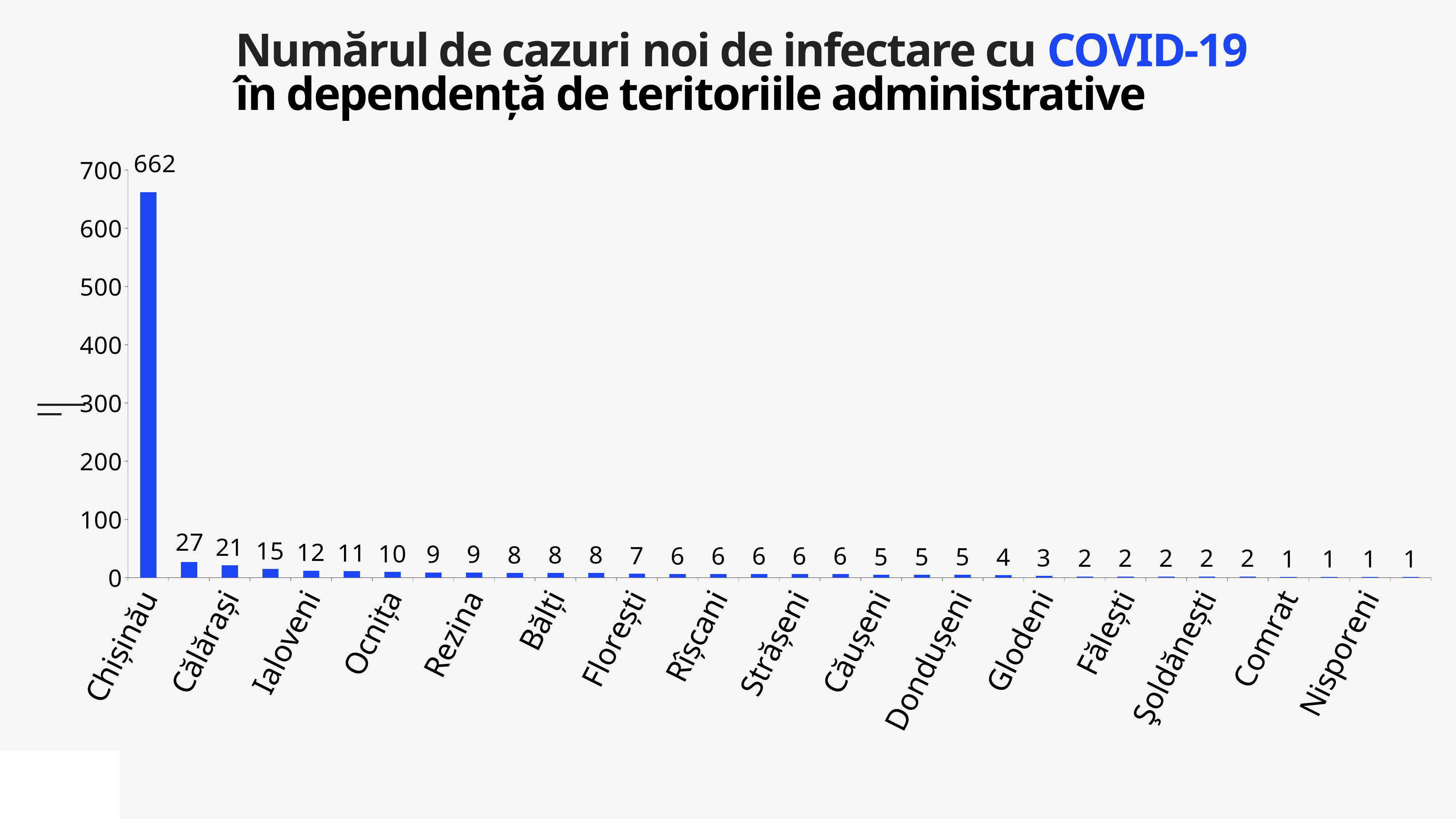
What kind of chart is shown on the slide? bar chart What is the value for Chișinău? 662 What colour are the bars on the chart? blue How many bars have a value of 1? 4 What is the lowest value shown on the chart? 1 What is the difference between the highest value (662) and the second highest value (27)? 635 Do the values rise or fall from left to right along the x axis? fall Is the value for Chișinău greater or less than 600? greater Which category has the highest value? Chișinău What is the highest tick value on the vertical axis? 700 How many bars are plotted on the chart? 32 What is the second highest value shown on the chart? 27